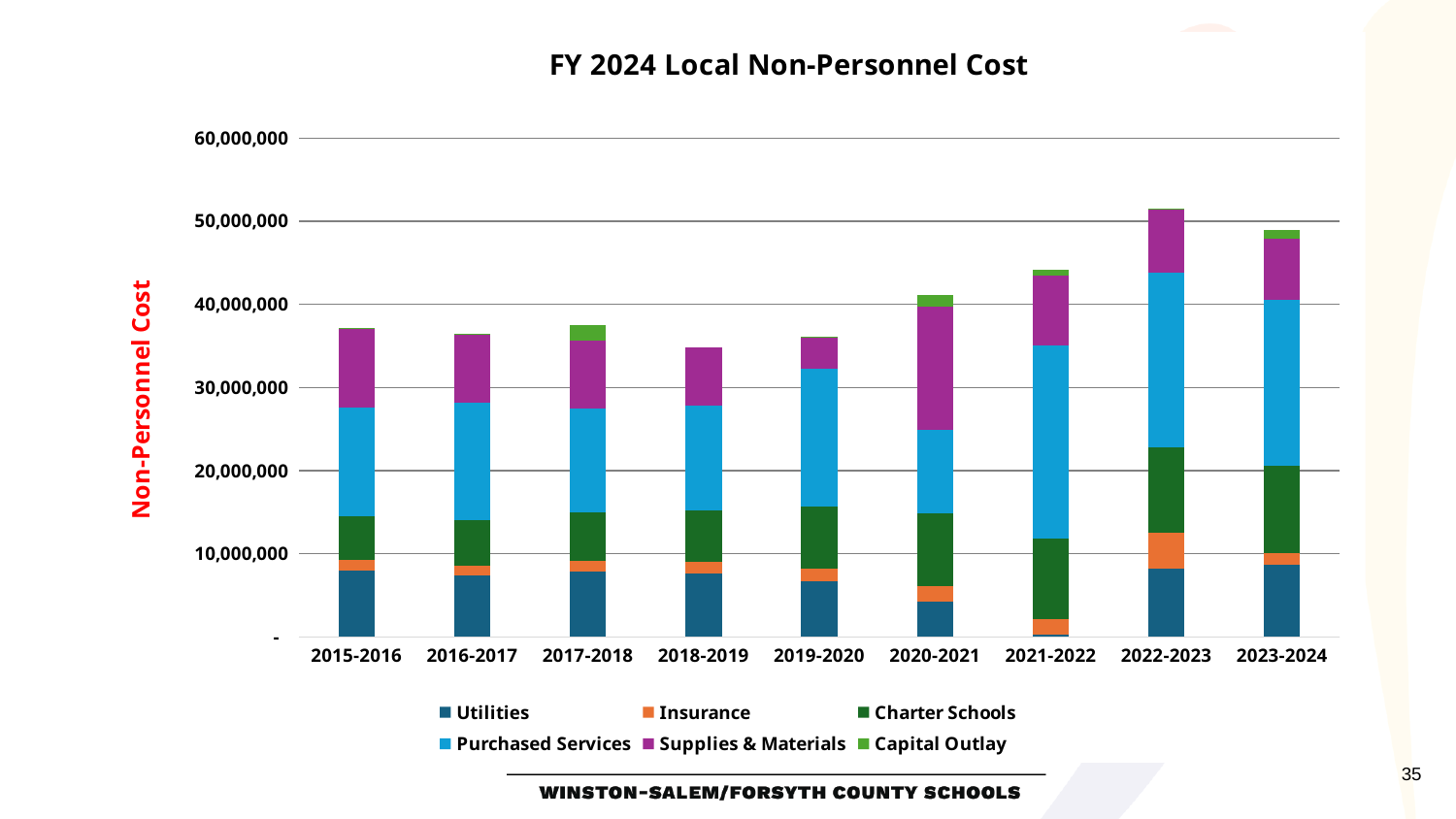
What is the title of the chart? FY 2024 Local Non-Personnel Cost Which series makes up the largest segment of the 2022-2023 bar? Purchased Services What is the label on the y axis? Non-Personnel Cost Is the total non-personnel cost for 2015-2016 greater or less than 40,000,000? less How many series does the legend list? 6 Which has the larger total non-personnel cost, 2019-2020 or 2020-2021? 2020-2021 Is the total non-personnel cost for 2021-2022 greater or less than 40,000,000? greater Which fiscal year has the highest total non-personnel cost? 2022-2023 Do the total non-personnel costs rise or fall from 2018-2019 to 2022-2023? rise Is the total non-personnel cost for 2022-2023 greater or less than 50,000,000? greater How many fiscal years are shown on the x axis? 9 What kind of chart is shown on the slide? Stacked bar chart